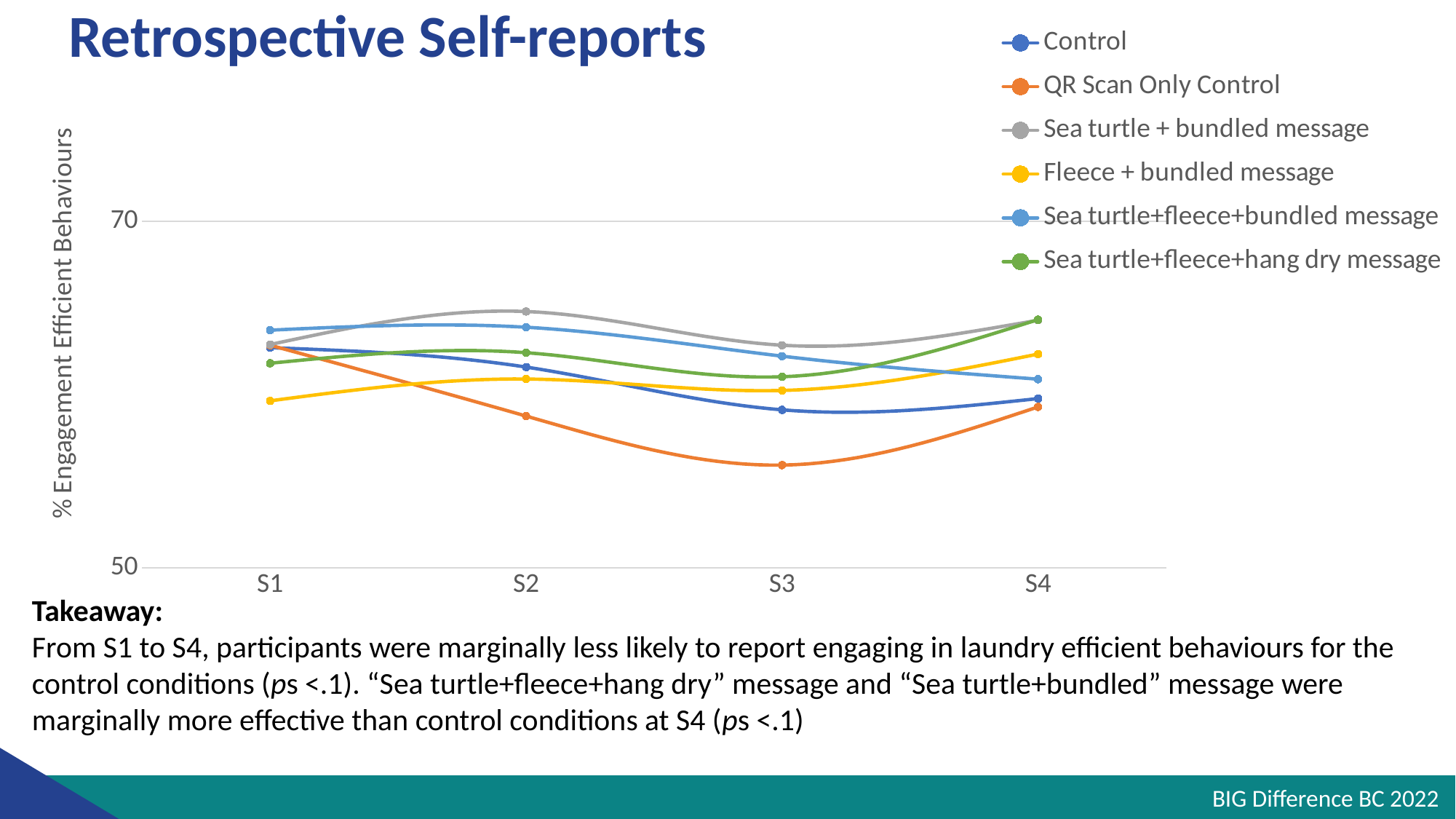
How many time points are shown along the x axis? 4 How many series does the legend list? 6 Is the value for QR Scan Only Control at S3 greater or less than 70? less Which series has the highest value at S2? Sea turtle + bundled message Which series has the lowest value at S3? QR Scan Only Control What is the label on the y axis? % Engagement Efficient Behaviours Which series has the highest value at S1? Sea turtle+fleece+bundled message At S3, which is larger: Control or QR Scan Only Control? Control Does the QR Scan Only Control series rise or fall from S1 to S3? fall What kind of chart is shown on the slide? line chart At S4, which is larger: Fleece + bundled message or Control? Fleece + bundled message Which series has the lowest value at S1? Fleece + bundled message